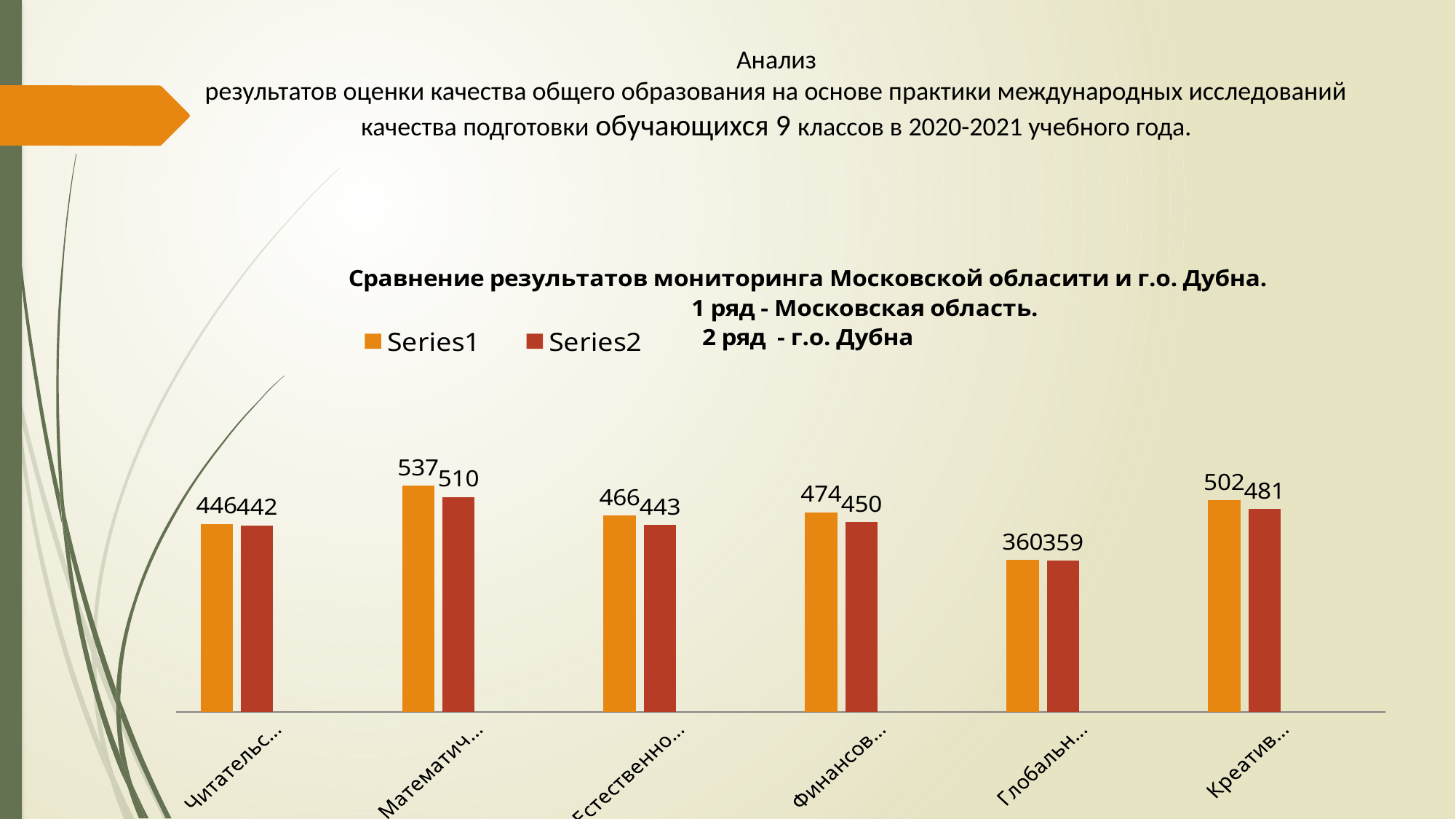
According to the text next to the legend, what does '1 ряд' (Series1) represent? Московская область For the sixth category from the left (labelled 'Креатив...'), which is larger: the Series1 value or the Series2 value? Series1 How many series does the chart legend list? 2 Which category has the highest Series1 value? Математич... (second category from the left) What is the Series2 value for the second category from the left (labelled 'Математич...')? 510 Which category has the lowest Series2 value? Глобальн... (fifth category from the left) What type of chart is shown on the slide? bar chart What is the difference between the Series1 and Series2 values for the second category from the left (labelled 'Математич...')? 27 What is the Series2 value for the fifth category from the left (labelled 'Глобальн...')? 359 What is the Series1 value for the second category from the left (labelled 'Математич...')? 537 What is the Series1 value for the first category from the left (labelled 'Читательс...')? 446 How many categories are shown along the x axis of the chart? 6